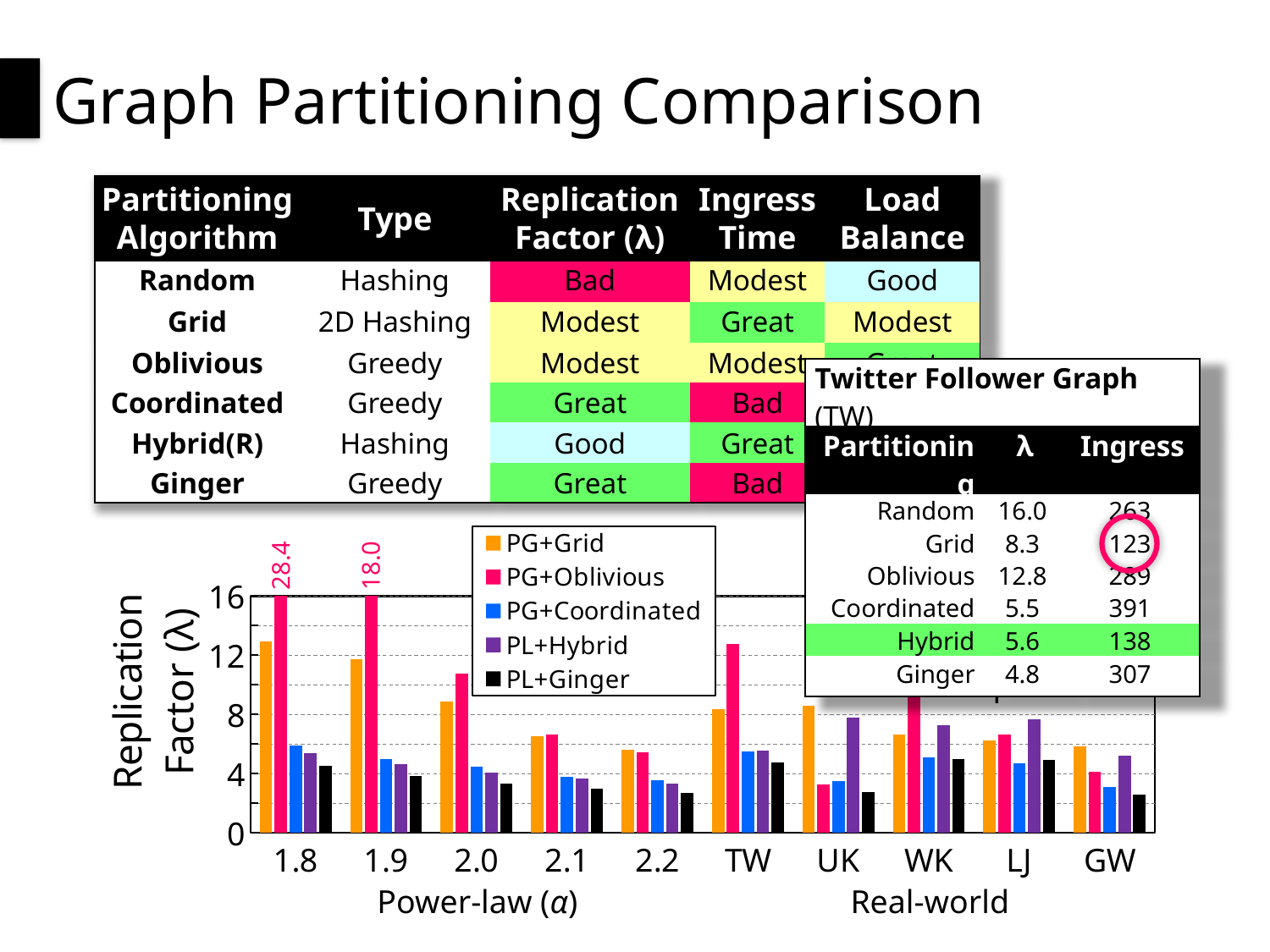
How many series does the legend of the bar chart list? 5 In the bar chart, does the PG+Grid replication factor rise or fall as α increases from 1.8 to 2.2? fall In the bar chart, what is the replication factor for PG+Oblivious at α = 1.8? 28.4 In the bar chart, what is the replication factor for PG+Oblivious at α = 1.9? 18.0 In the bar chart, is the value for PL+Ginger at α = 2.2 greater or less than 4? less How many categories are shown along the x axis of the bar chart? 10 In the bar chart, what is the difference between the PG+Oblivious values at α = 1.8 and α = 1.9? 10.4 In the bar chart, which is larger for TW: PG+Oblivious or PG+Grid? PG+Oblivious What kind of chart is shown at the bottom of the slide? bar chart What is the y-axis label of the bar chart? Replication Factor (λ) In the bar chart, is the value for PG+Grid at α = 1.8 greater or less than 12? greater In the bar chart, which series has the highest replication factor at α = 1.8? PG+Oblivious